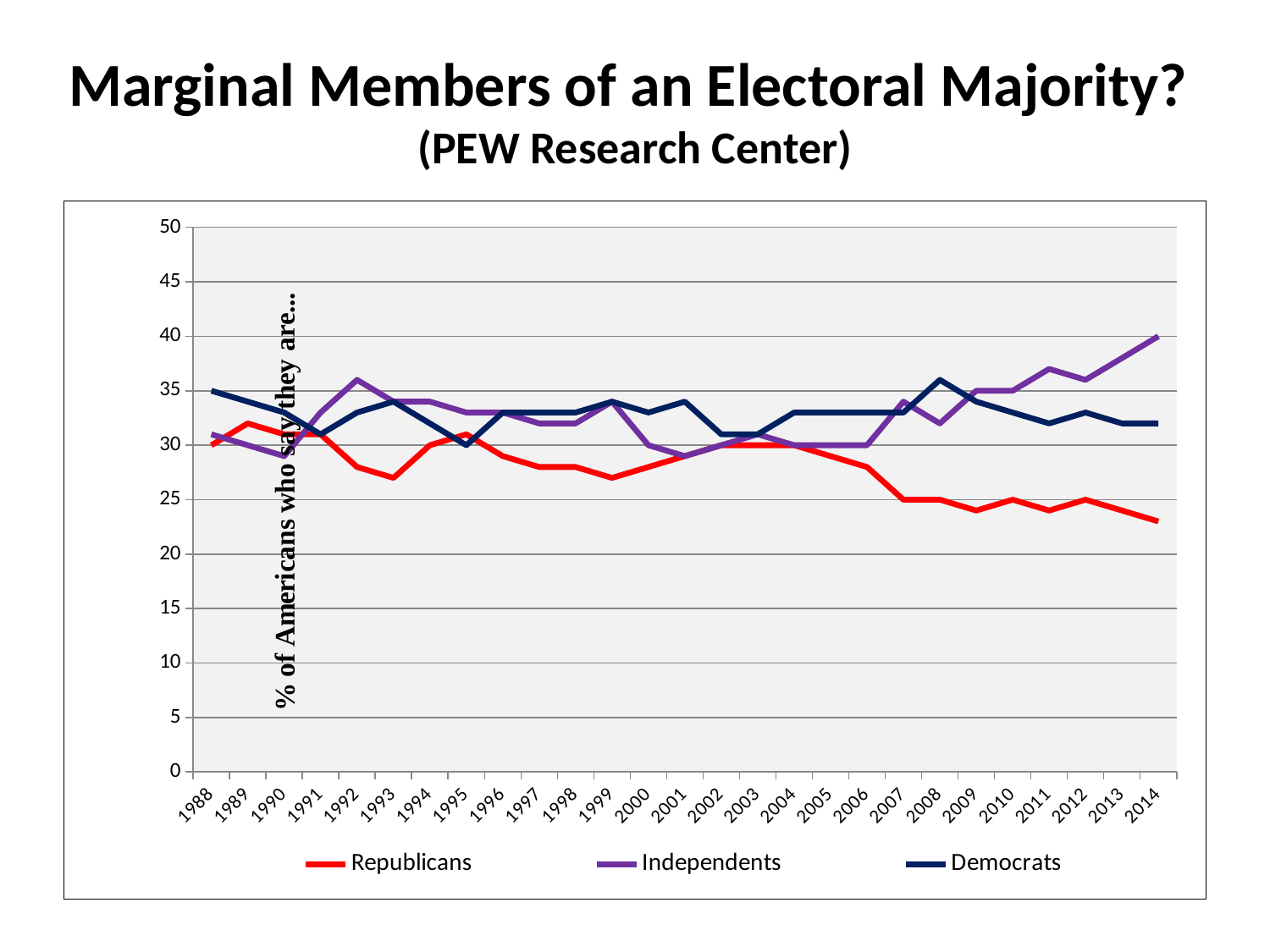
Is the value for Republicans in 1993 greater or less than 30? less In 2014, which is larger, the value for Independents or the value for Republicans? Independents How many series does the legend list? 3 What kind of chart is shown on the slide? Line chart How many years are plotted along the x axis? 27 Which group has the lowest value in 2014? Republicans Is the value for Republicans in 2014 greater or less than 25? less Is the value for Independents in 2014 greater or less than 35? greater Which group has the highest value in 2014? Independents Does the Independents line generally rise or fall from 2006 to 2014? Rise Which three groups are listed in the legend? Republicans, Independents, Democrats Does the Republicans line generally rise or fall from 1988 to 2014? Fall